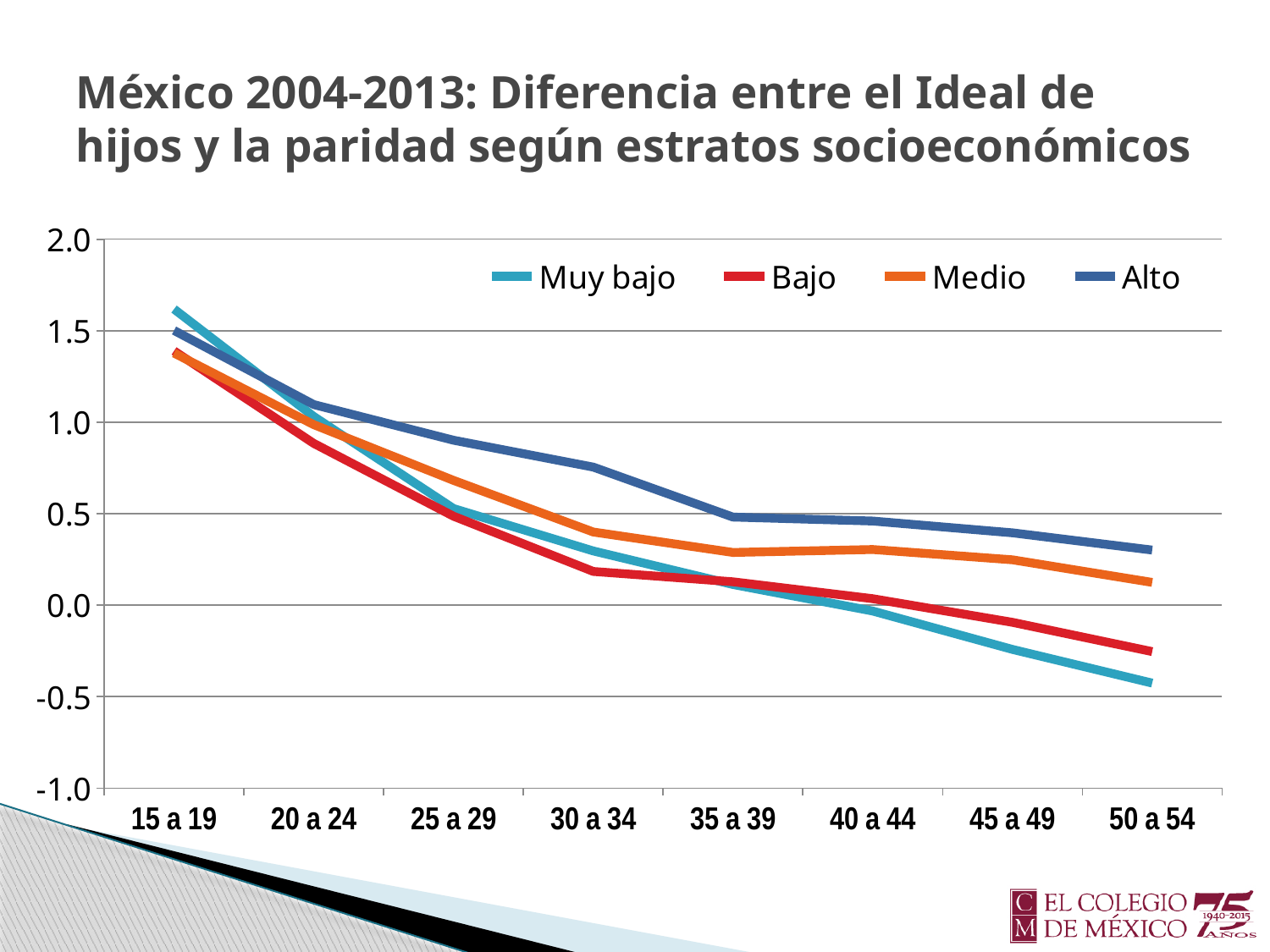
Is the value for Alto at 35 a 39 greater or less than 1.0? less Which series is drawn in red? Bajo Which series is highest at the 50 a 54 age group? Alto Is the value for Muy bajo at 50 a 54 greater or less than 0.0? less How many age groups are shown on the x axis? 8 At 30 a 34, which is larger, the value for Alto or the value for Bajo? Alto Which series is lowest at the 50 a 54 age group? Muy bajo How many series does the legend list? 4 Is the value for Bajo at 50 a 54 greater or less than 0.0? less Do the values for Muy bajo rise or fall from 15 a 19 to 50 a 54? fall What kind of chart is shown on the slide? line chart